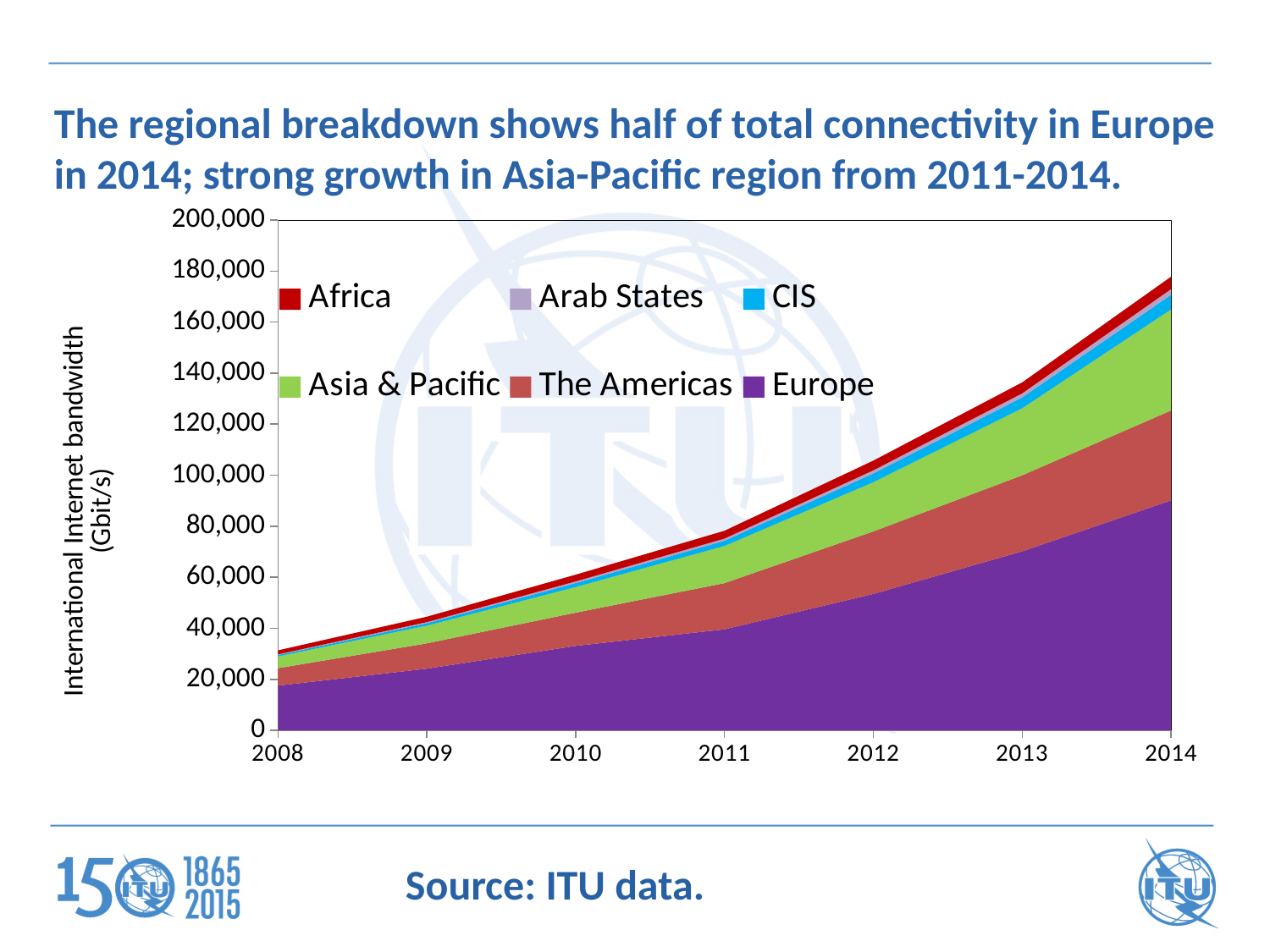
Does total international Internet bandwidth rise or fall from 2008 to 2014? Rises How many years are plotted along the x axis? 7 What kind of chart is shown on the slide? Stacked area chart Is the total international Internet bandwidth in 2014 greater or less than 160,000? greater Is the total international Internet bandwidth in 2013 greater or less than 120,000? greater In which year is total international Internet bandwidth highest? 2014 Which region contributes the largest share of international Internet bandwidth in 2014? Europe What is the label of the y axis? International Internet bandwidth (Gbit/s) In which year is total international Internet bandwidth lowest? 2008 In 2014, which is larger: the bandwidth for Europe or for Asia & Pacific? Europe How many series does the legend list? 6 Is the total international Internet bandwidth in 2008 greater or less than 40,000? less